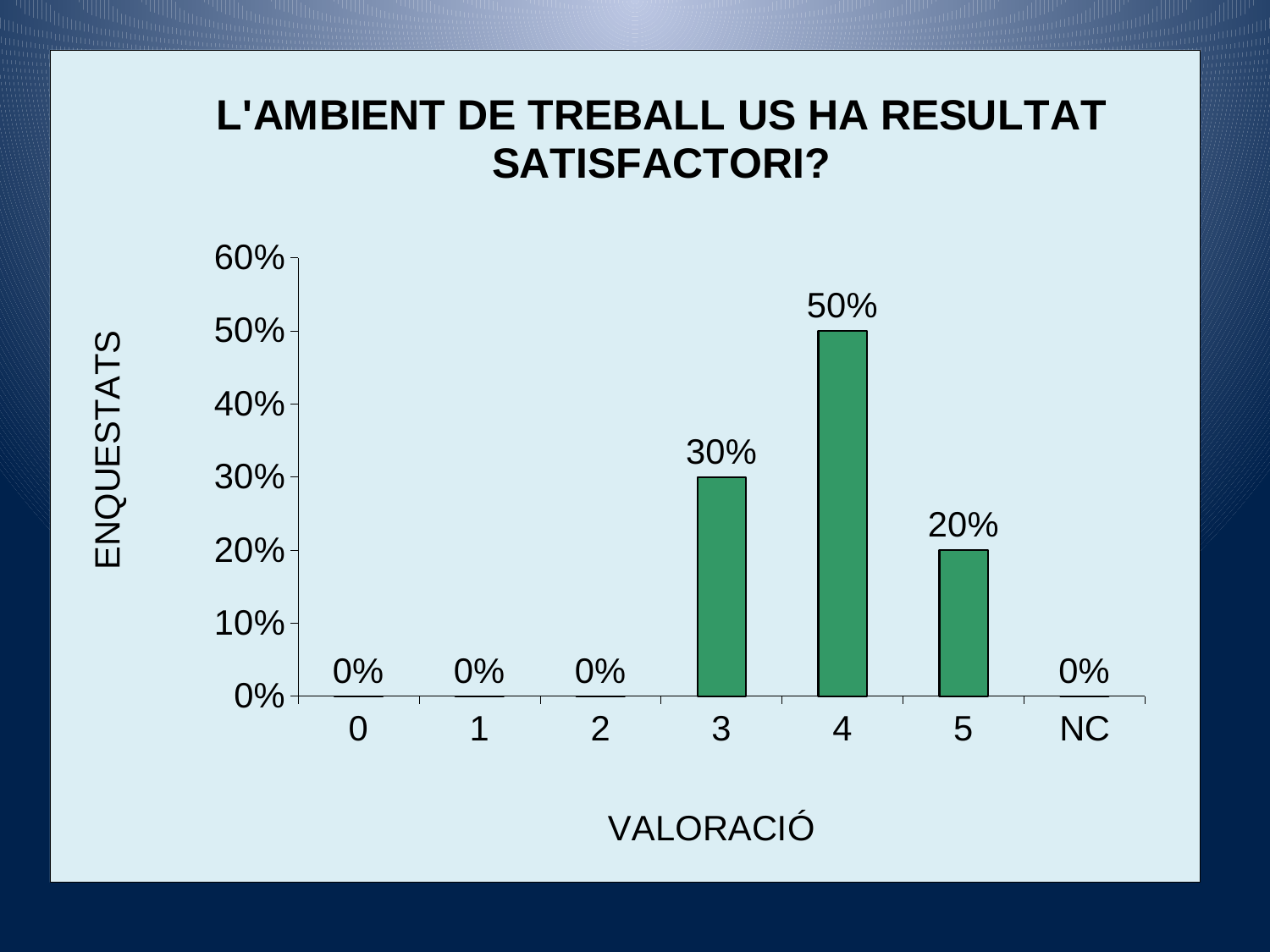
What percentage of respondents gave a rating of 4? 50% What is the difference between the percentage for rating 3 and the percentage for rating 5? 10% How many categories are shown on the x axis? 7 Which is larger, the percentage for rating 3 or the percentage for rating 5? rating 3 What percentage of respondents gave a rating of 3? 30% What percentage of respondents gave a rating of 5? 20% What percentage of respondents answered NC? 0% Which rating received the highest percentage of respondents? 4 What kind of chart is shown on the slide? bar chart What is the title of the chart? L'AMBIENT DE TREBALL US HA RESULTAT SATISFACTORI? What is the label of the x axis? VALORACIÓ What is the difference between the percentage for rating 4 and the percentage for rating 5? 30%